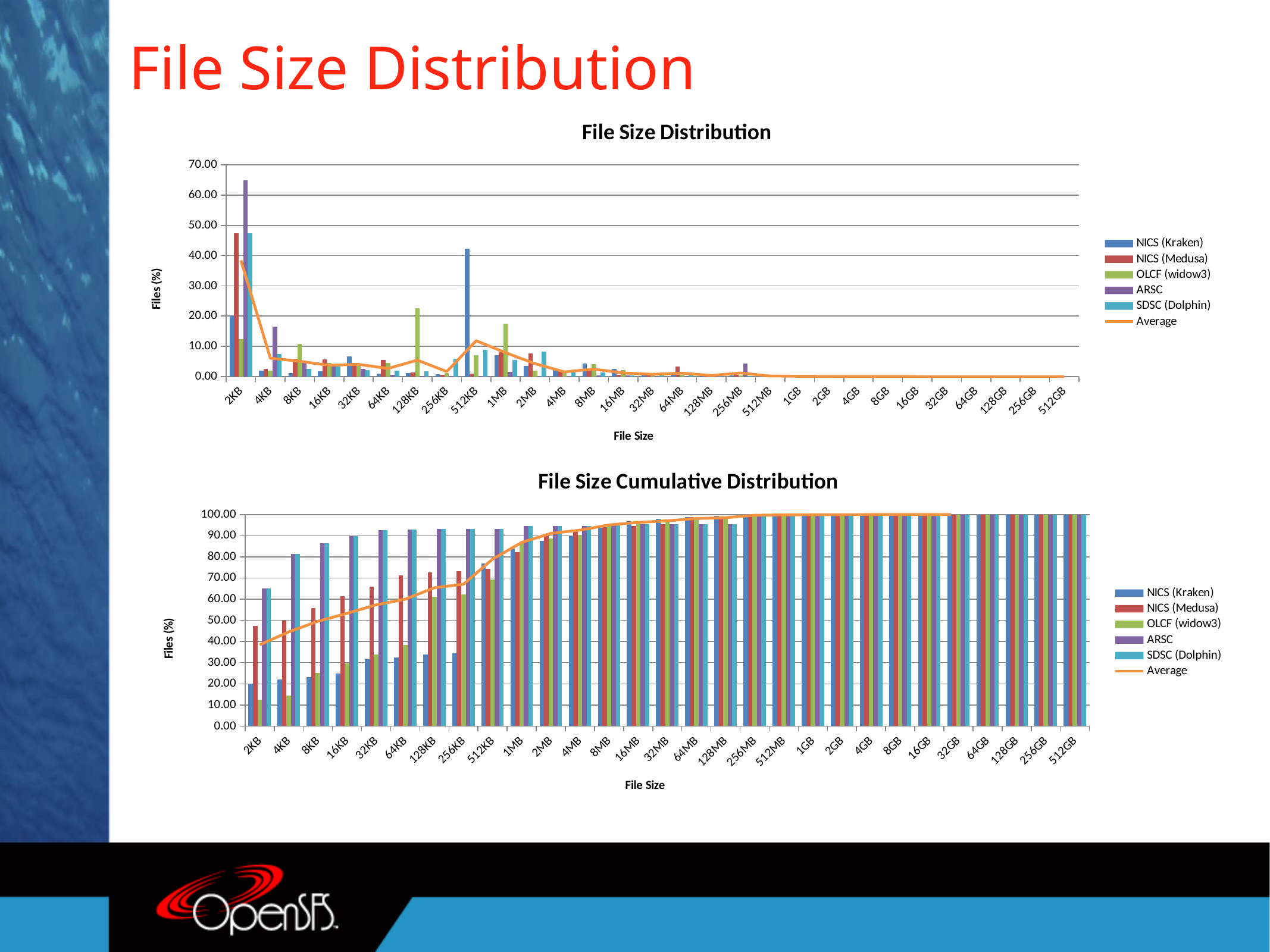
In the top "File Size Distribution" chart, is the value for OLCF (widow3) at 128KB greater or less than 20.00? greater In the top "File Size Distribution" chart, is the value for NICS (Kraken) at 512KB greater or less than 40.00? greater What is the label of the y axis on the bottom "File Size Cumulative Distribution" chart? Files (%) In the top "File Size Distribution" chart, is the value for ARSC at 2KB greater or less than 60.00? greater How many file size categories are shown on the x axis of the bottom "File Size Cumulative Distribution" chart? 29 In the bottom "File Size Cumulative Distribution" chart, do the values for the Average line rise or fall as file size increases along the x axis? rise How many series does the legend of the top "File Size Distribution" chart list? 6 In the top "File Size Distribution" chart, which is larger at 2KB: NICS (Kraken) or NICS (Medusa)? NICS (Medusa) In the top "File Size Distribution" chart, which series has the highest bar at 2KB? ARSC What type of chart is the top chart titled "File Size Distribution"? bar chart with a line